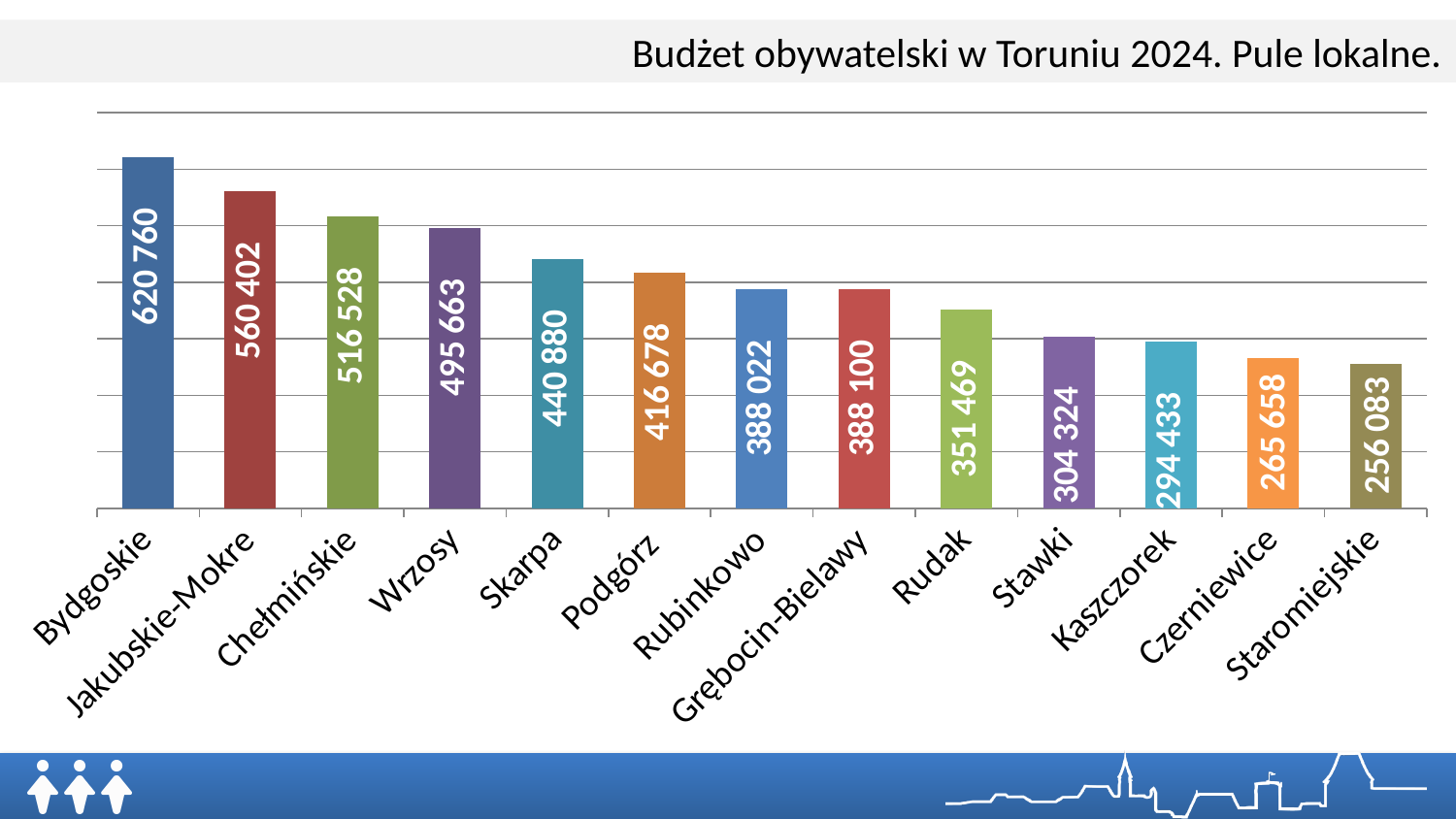
What is the difference between the values for Bydgoskie and Jakubskie-Mokre? 60 358 Which is larger, the value for Wrzosy or the value for Podgórz? Wrzosy What is the value for Bydgoskie? 620 760 How many categories are shown in the chart? 13 What is the value for Kaszczorek? 294 433 What is the value for Skarpa? 440 880 Which category has the lowest value? Staromiejskie What is the title of the slide? Budżet obywatelski w Toruniu 2024. Pule lokalne. Which is larger, the value for Rudak or the value for Stawki? Rudak What is the difference between the values for Czerniewice and Staromiejskie? 9 575 What kind of chart is shown on the slide? Bar chart Which category has the highest value? Bydgoskie